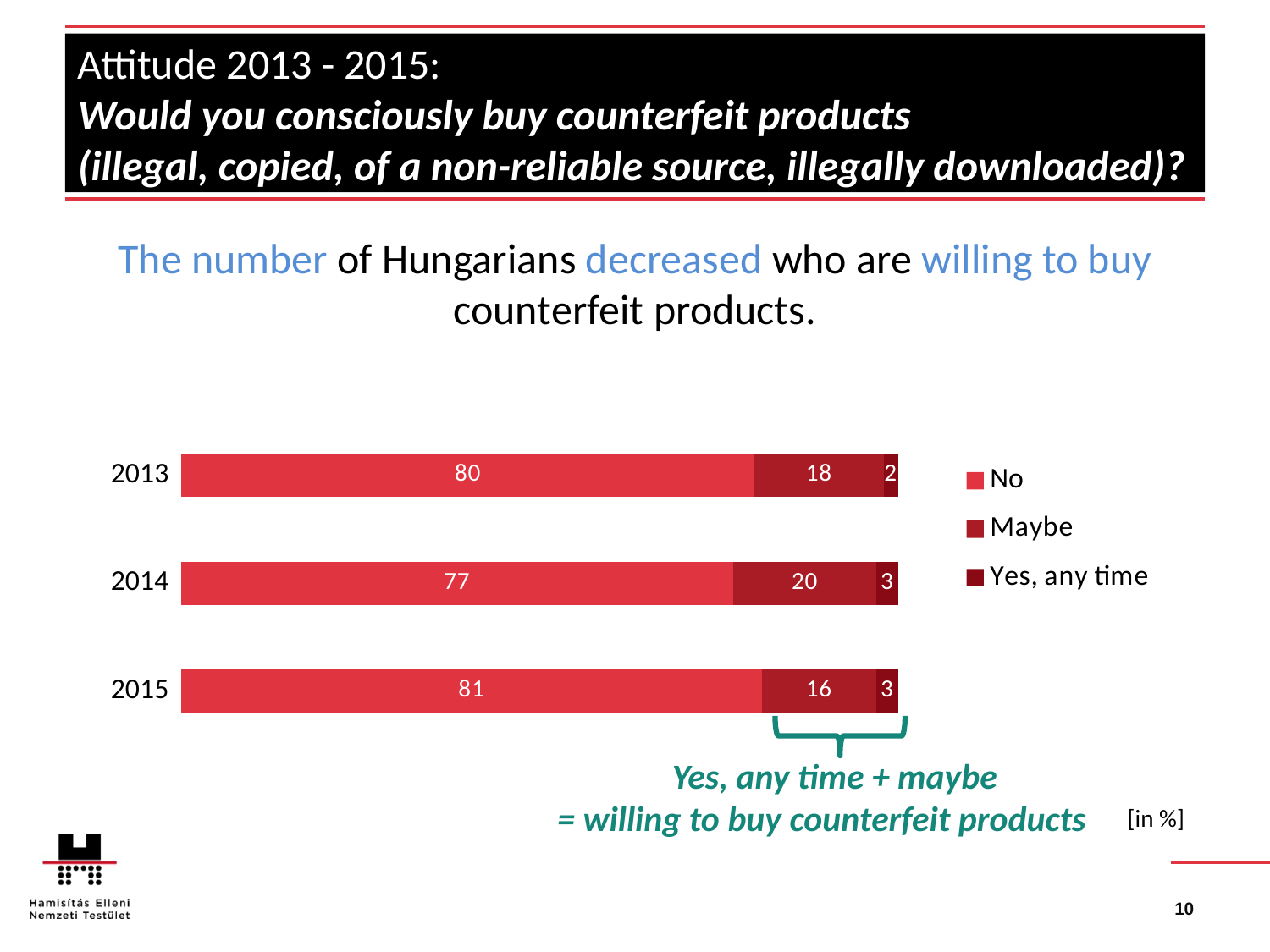
What kind of chart is shown on the slide? Stacked bar chart What is the value for "Maybe" in 2015? 16 What is the value for "Yes, any time" in 2015? 3 What is the total of the "Maybe" and "Yes, any time" values for 2013? 20 What is the value for "No" in 2013? 80 How many years are shown in the chart? 3 Which is larger, the "No" value for 2013 or for 2014? 2013 What is the difference between the "Maybe" values for 2014 and 2015? 4 Which year has the lowest value for "Maybe"? 2015 How many series does the legend list? 3 Which year has the highest value for "No"? 2015 What is the value for "Maybe" in 2014? 20